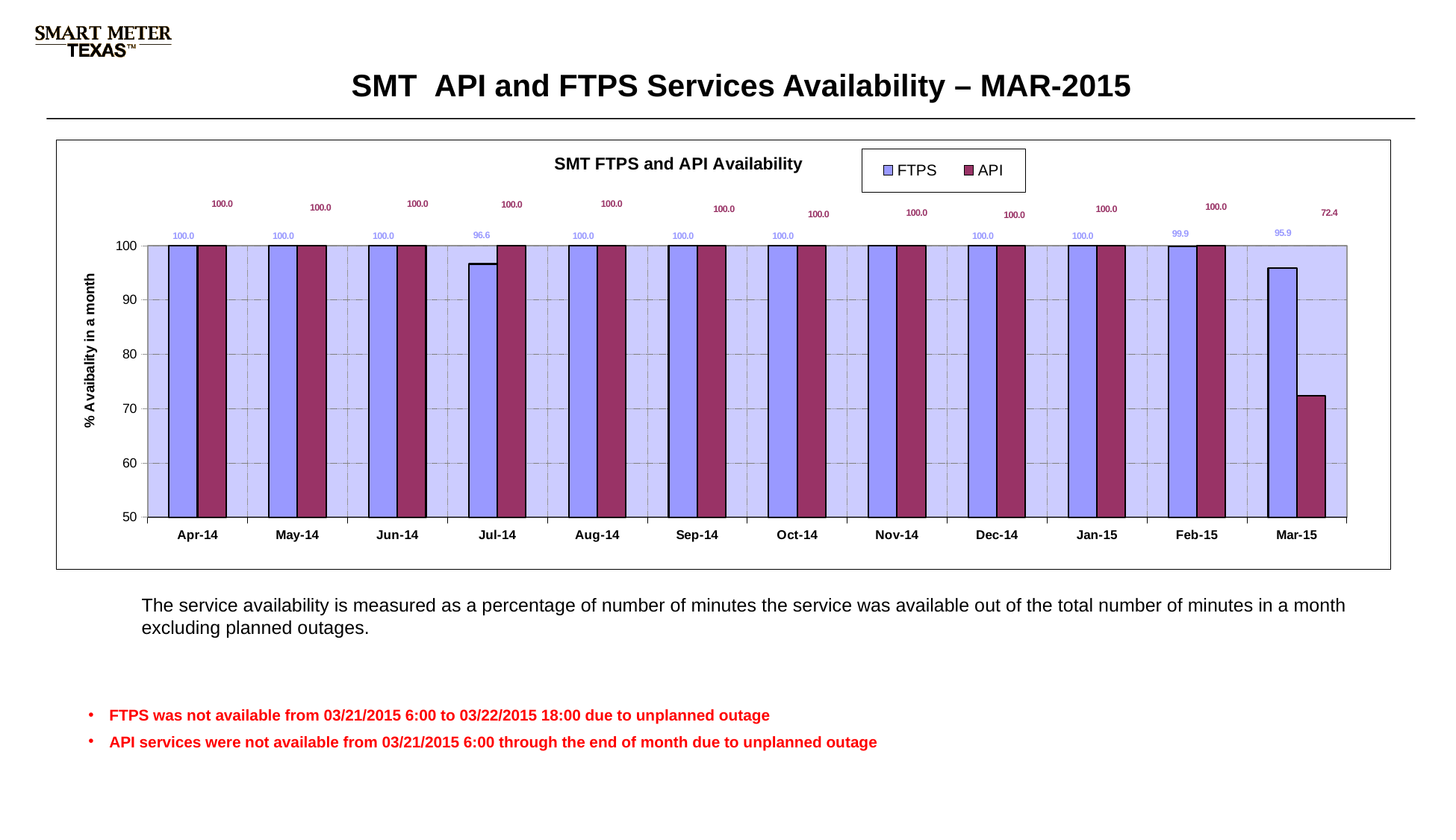
What is the FTPS availability value for Mar-15? 95.9 Which month has the lowest API availability? Mar-15 What is the FTPS availability value for Feb-15? 99.9 Is the API value for Mar-15 greater or less than 80? less Which is larger in Jul-14, the FTPS value or the API value? API What is the FTPS availability value for Jul-14? 96.6 What is the difference between the FTPS and API availability values for Mar-15? 23.5 How many months are shown on the x axis? 12 What type of chart is shown on the slide? bar chart How many series does the legend list? 2 Which month has the lowest FTPS availability? Mar-15 What is the API availability value for Mar-15? 72.4